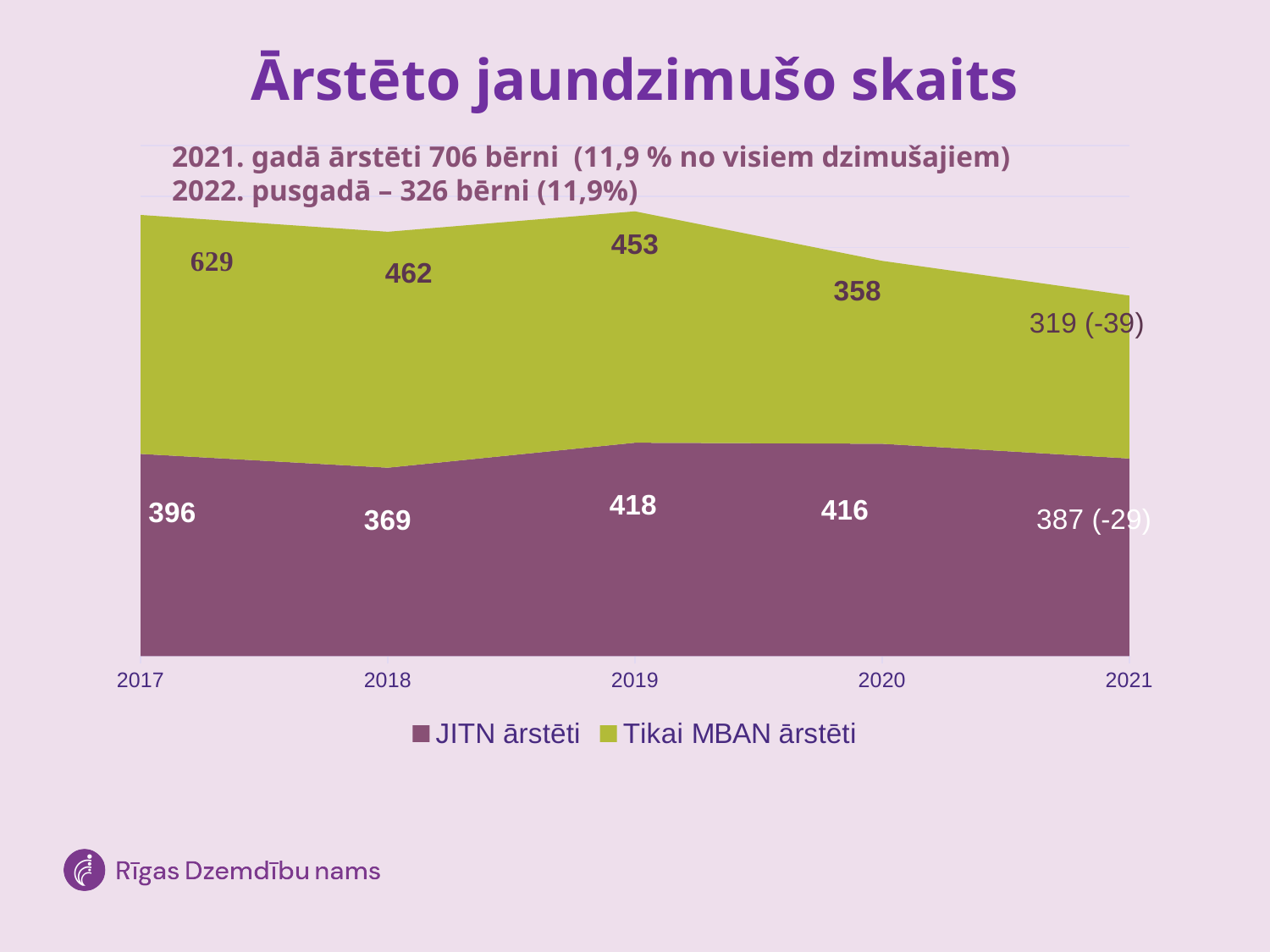
In which year is the Tikai MBAN ārstēti value highest? 2017 What is the value for JITN ārstēti in 2019? 418 How many series does the legend list? 2 In which year is the JITN ārstēti value lowest? 2018 What is the value for Tikai MBAN ārstēti in 2020? 358 What is the value for JITN ārstēti in 2018? 369 How many years are shown on the x axis? 5 Which is larger in 2020: JITN ārstēti or Tikai MBAN ārstēti? JITN ārstēti What is the total of JITN ārstēti and Tikai MBAN ārstēti in 2021? 706 What kind of chart is shown on the slide? Stacked area chart